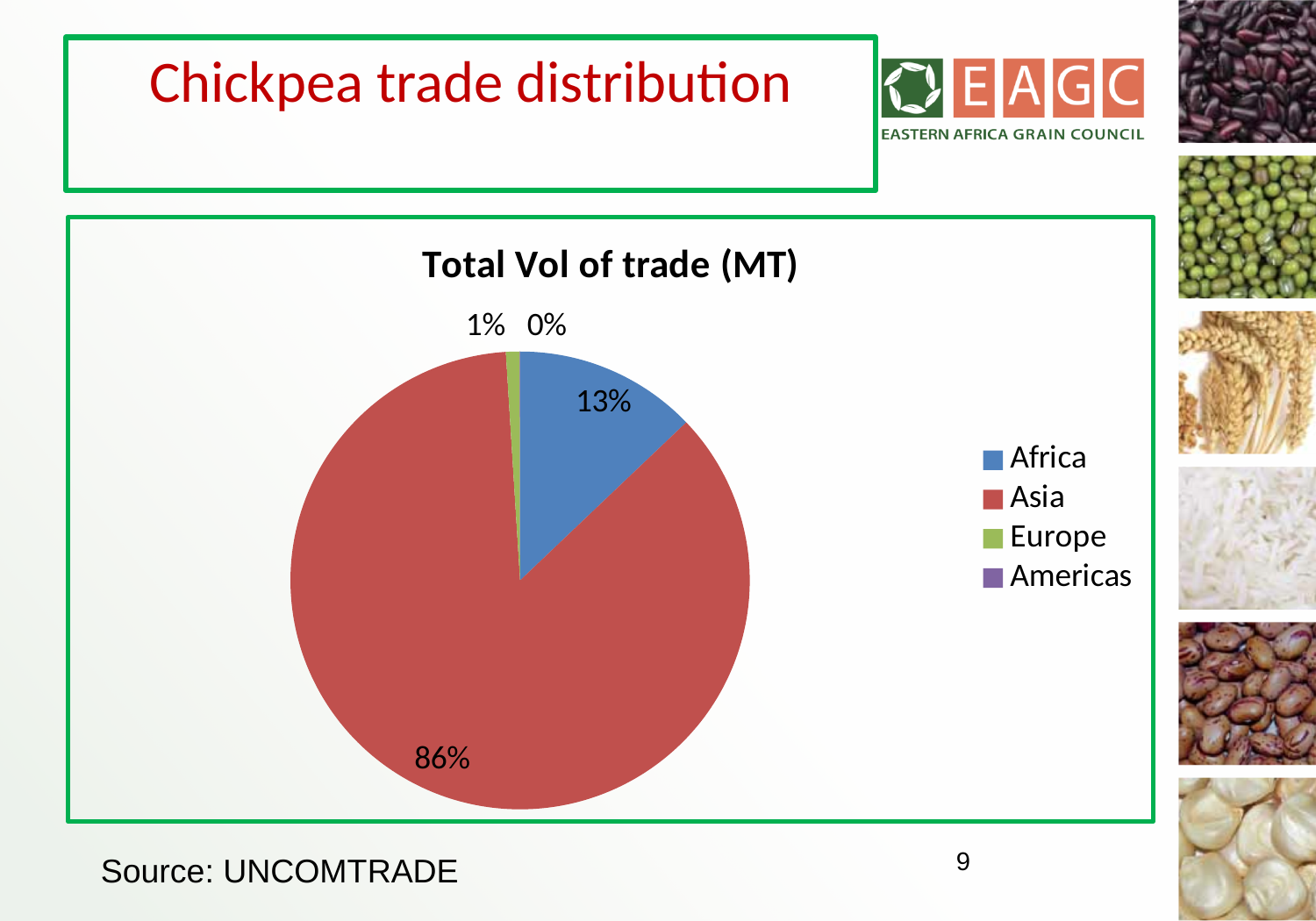
What share of the total volume of trade does Asia account for? 86% What is the difference in percentage points between Asia's share and Africa's share? 73 Which colour represents Asia in the pie chart? red What kind of chart is shown on the slide? pie chart Which has a larger share of trade, Africa or Europe? Africa What share of the total volume of trade does Africa account for? 13% Which region has the smallest share of the total volume of trade? Americas What is the title of the chart? Total Vol of trade (MT) What share of the total volume of trade does Europe account for? 1% How many regions are listed in the legend? 4 Which region has the largest share of the total volume of trade? Asia